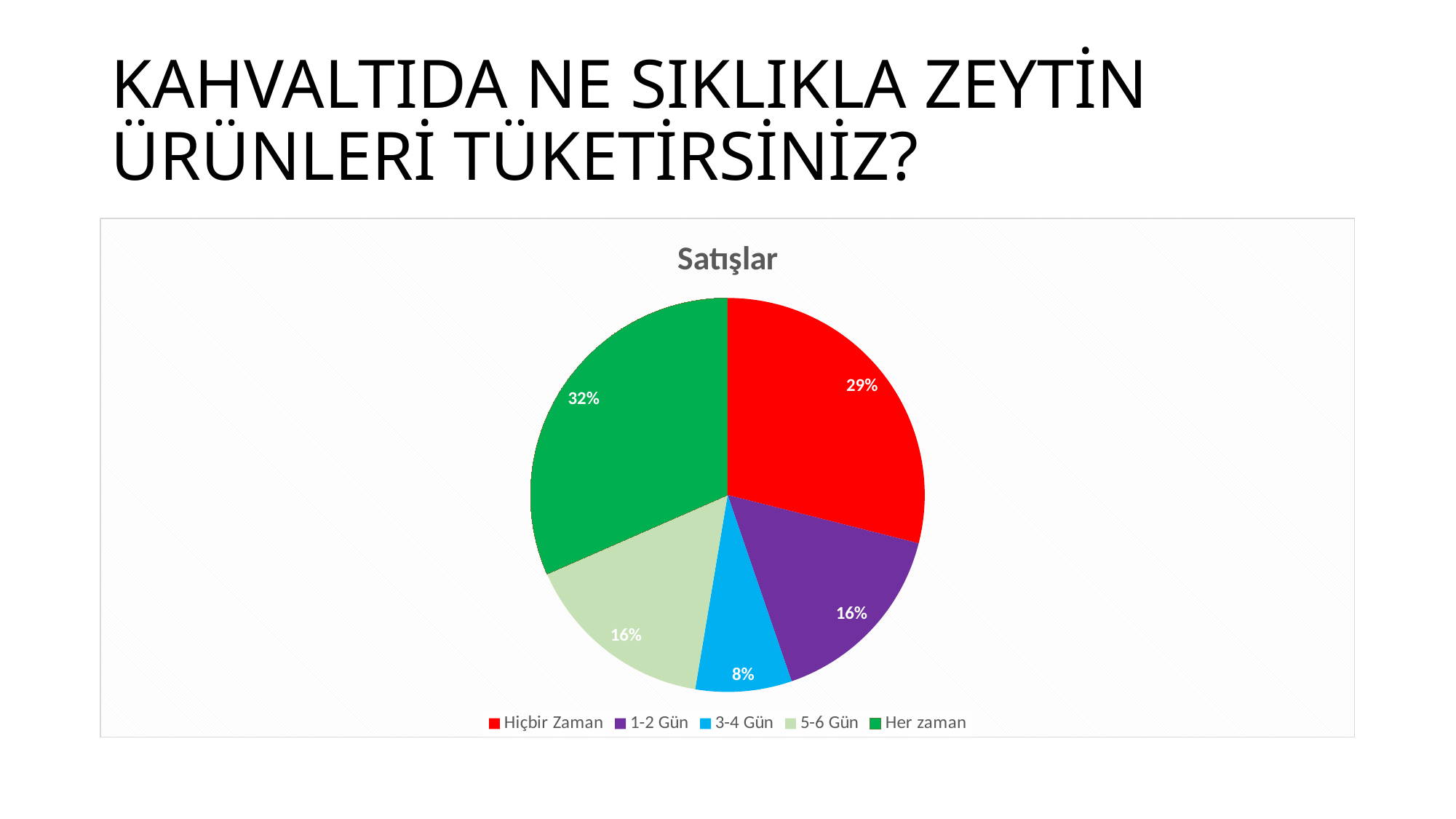
What is the difference in percentage points between 'Her zaman' and 'Hiçbir Zaman'? 3 What type of chart is shown on the slide? Pie chart What percentage share does the 'Her zaman' slice have? 32% What percentage share does the 'Hiçbir Zaman' slice have? 29% What percentage share does the '1-2 Gün' slice have? 16% What is the title of the chart? Satışlar Which category has the largest share of the pie? Her zaman How many categories does the legend list? 5 Which is larger, the share for 'Hiçbir Zaman' or the share for '5-6 Gün'? Hiçbir Zaman What percentage share does the '3-4 Gün' slice have? 8% Which category has the smallest share of the pie? 3-4 Gün What colour is the 'Hiçbir Zaman' slice? Red